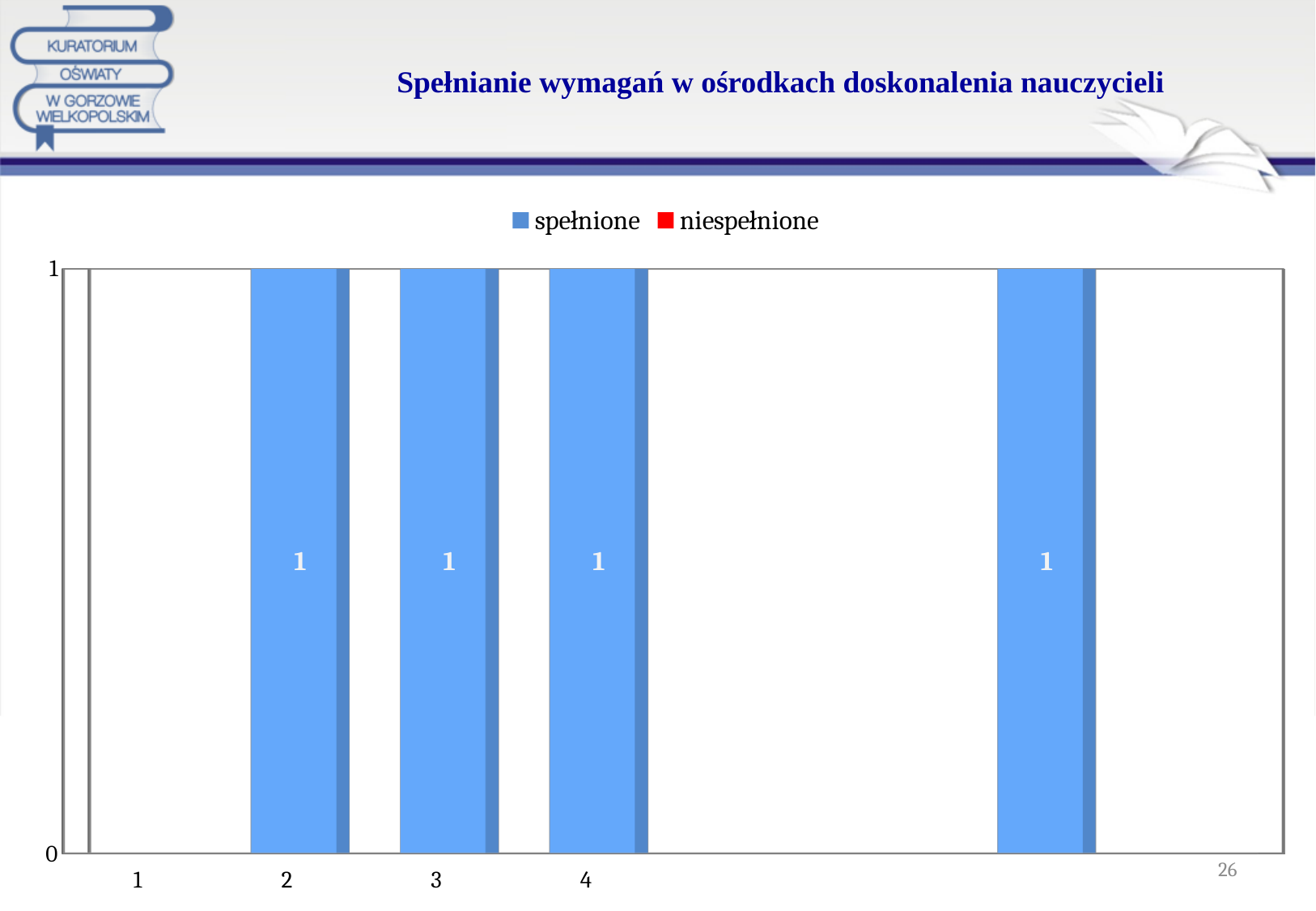
What is the maximum value shown on the vertical axis? 1 How many series does the legend list? 2 What is the title of the chart? Spełnianie wymagań w ośrodkach doskonalenia nauczycieli Which of the labeled categories (1 to 4) has no visible bar? 1 What are the two series named in the legend? spełnione, niespełnione What is the value of the spełnione bar for category 3? 1 Which is larger, the spełnione value for category 2 or for category 1? category 2 What kind of chart is shown on the slide? bar chart What is the value of the spełnione bar for category 2? 1 How many bars on the chart carry the data label 1? 4 What is the difference between the spełnione values for category 3 and category 4? 0 What is the value of the spełnione bar for category 4? 1